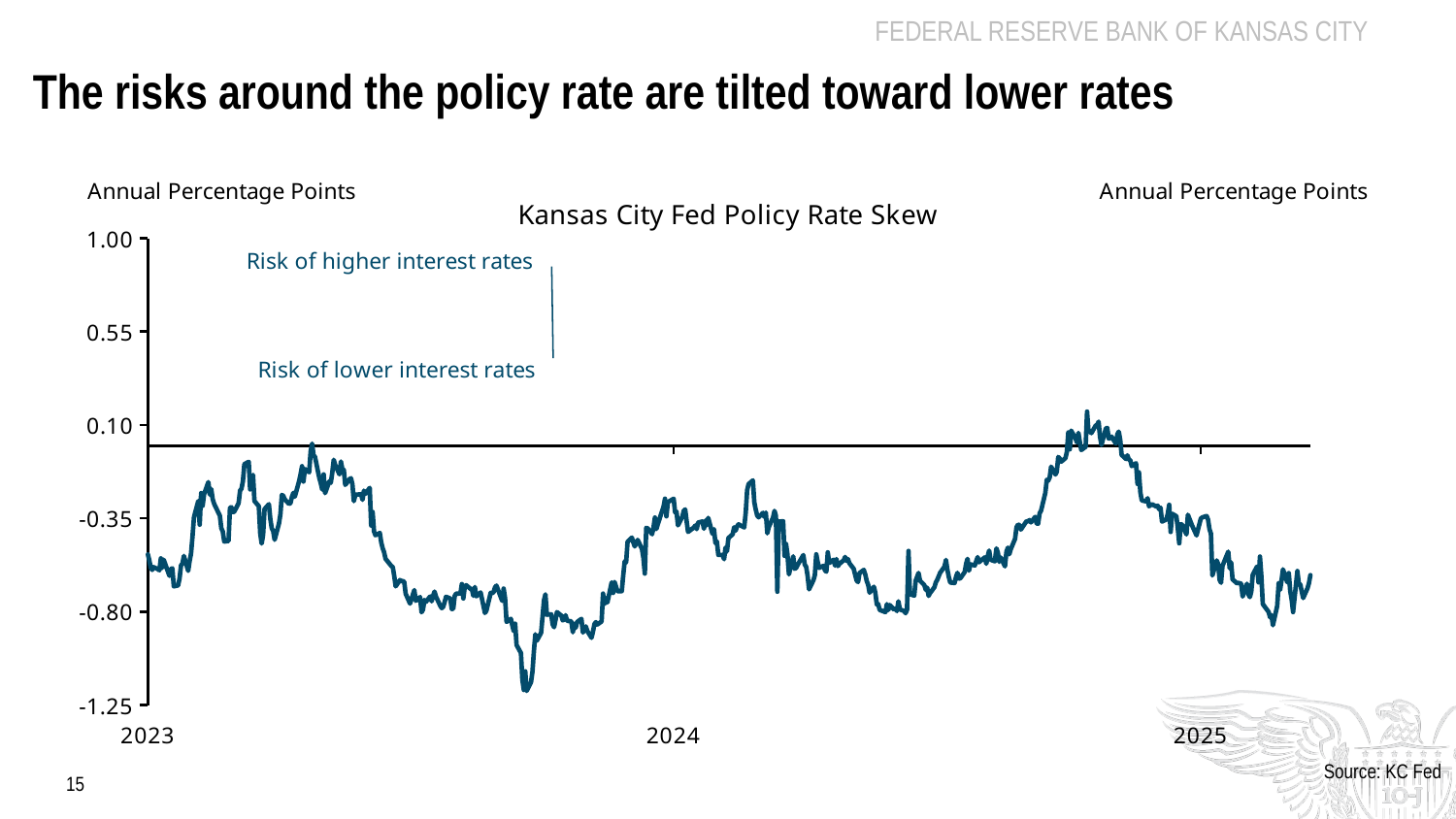
Is the value of the policy rate skew at the start of 2025 greater or less than -0.80? greater How many years are labeled on the x axis of the chart? 3 What kind of chart is shown on the slide? Line chart What is the title of the chart? Kansas City Fed Policy Rate Skew Is the lowest point of the policy rate skew line greater or less than -0.80? less Is the value of the policy rate skew at the start of 2024 greater or less than -0.35? less How many lines are plotted in the chart? 1 What unit is shown on the vertical axis label of the chart? Annual Percentage Points Does the policy rate skew line rise or fall between mid-2024 and the start of 2025? rise Does the policy rate skew line rise or fall from the start of 2025 to the end of the series? fall